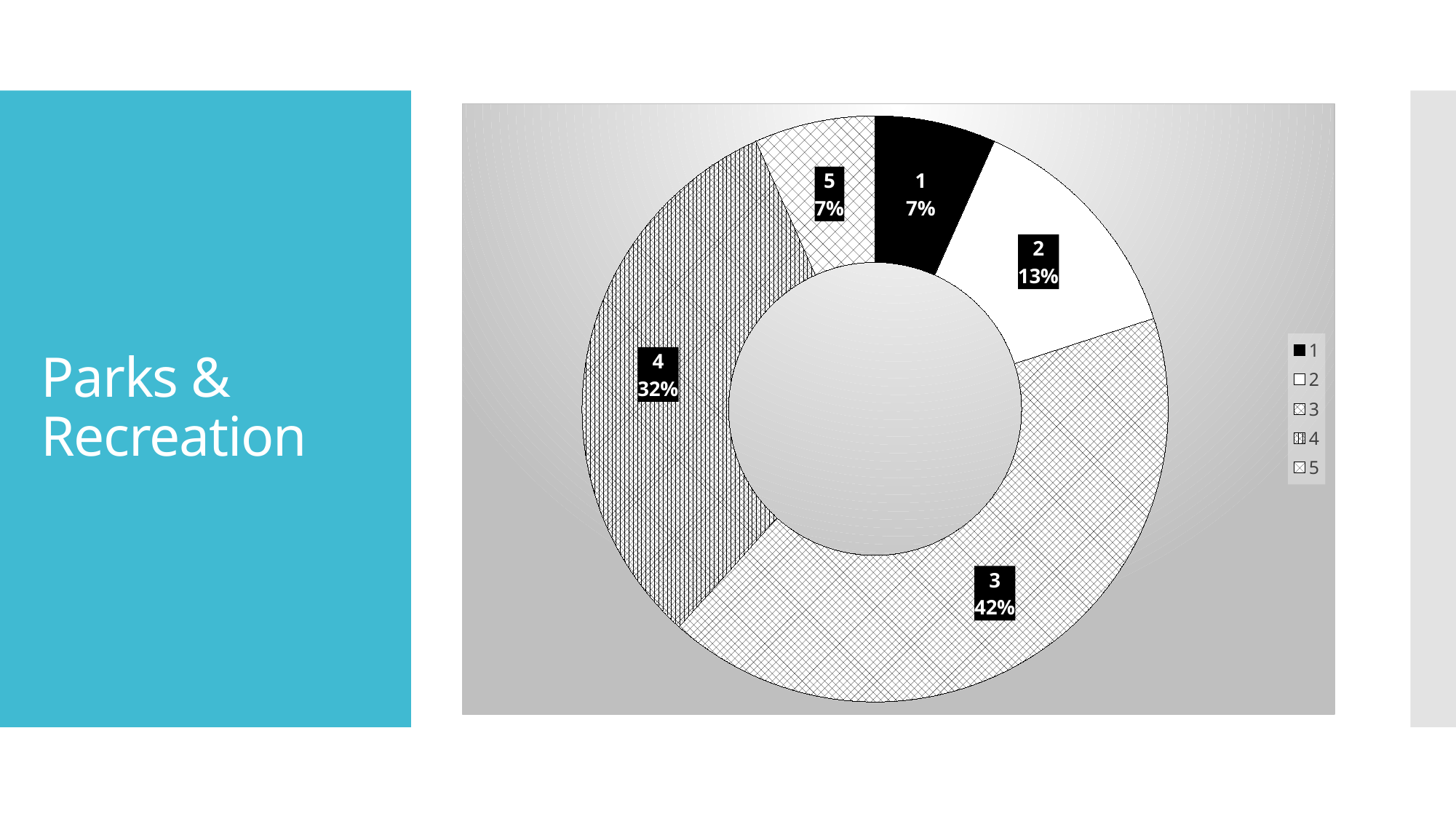
What is the title text on the left side of the slide? Parks & Recreation What percentage is shown for category 4? 32% What percentage is shown for category 2? 13% How many categories does the legend list? 5 Which legend entry is shown with a solid black fill? 1 What kind of chart is shown on the slide? Doughnut chart What is the combined share of categories 1 and 5? 14% Which is larger, the share for category 2 or the share for category 5? 2 What percentage is shown for category 3? 42% Which category has the largest share of the chart? 3 What is the difference in percentage points between category 3 and category 4? 10 What percentage is shown for category 1? 7%